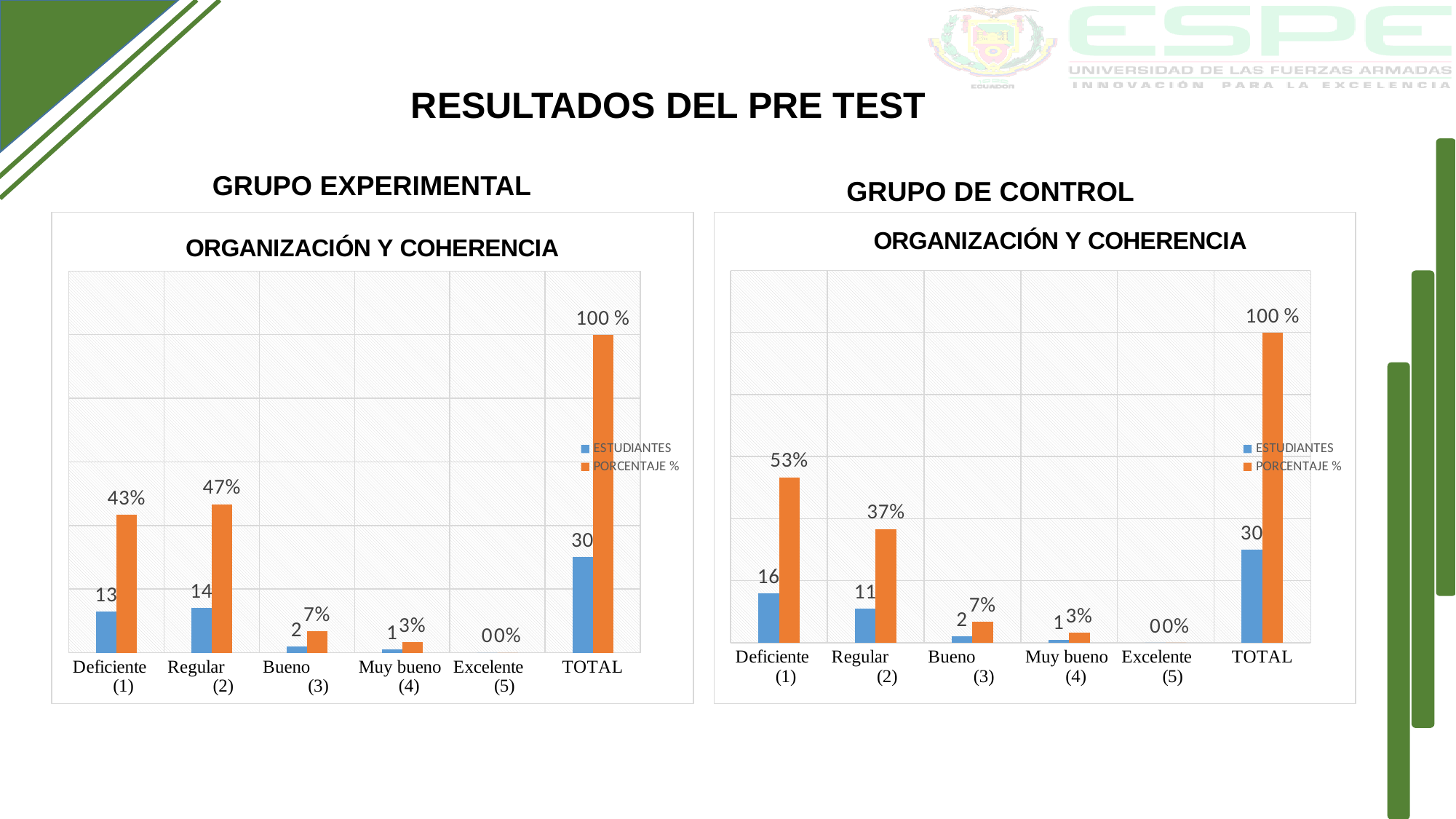
In the GRUPO EXPERIMENTAL chart, what is the PORCENTAJE % for Bueno (3)? 7% In the GRUPO EXPERIMENTAL chart, which has more ESTUDIANTES: Deficiente (1) or Regular (2)? Regular (2) How many categories are shown on the x axis of the GRUPO EXPERIMENTAL chart? 6 In the GRUPO DE CONTROL chart, what is the difference in ESTUDIANTES between Deficiente (1) and Regular (2)? 5 In the GRUPO DE CONTROL chart, how many ESTUDIANTES are in the Regular (2) category? 11 In the GRUPO DE CONTROL chart, which category (excluding TOTAL) has the highest PORCENTAJE %? Deficiente (1) How many series does the legend of the GRUPO DE CONTROL chart list? 2 What is the title shown inside the GRUPO EXPERIMENTAL chart? ORGANIZACIÓN Y COHERENCIA In the GRUPO EXPERIMENTAL chart, how many ESTUDIANTES are in the Regular (2) category? 14 In the GRUPO EXPERIMENTAL chart, which category (excluding TOTAL) has the highest number of ESTUDIANTES? Regular (2) What type of chart is used for GRUPO DE CONTROL? Bar chart In the GRUPO DE CONTROL chart, what is the PORCENTAJE % for Deficiente (1)? 53%